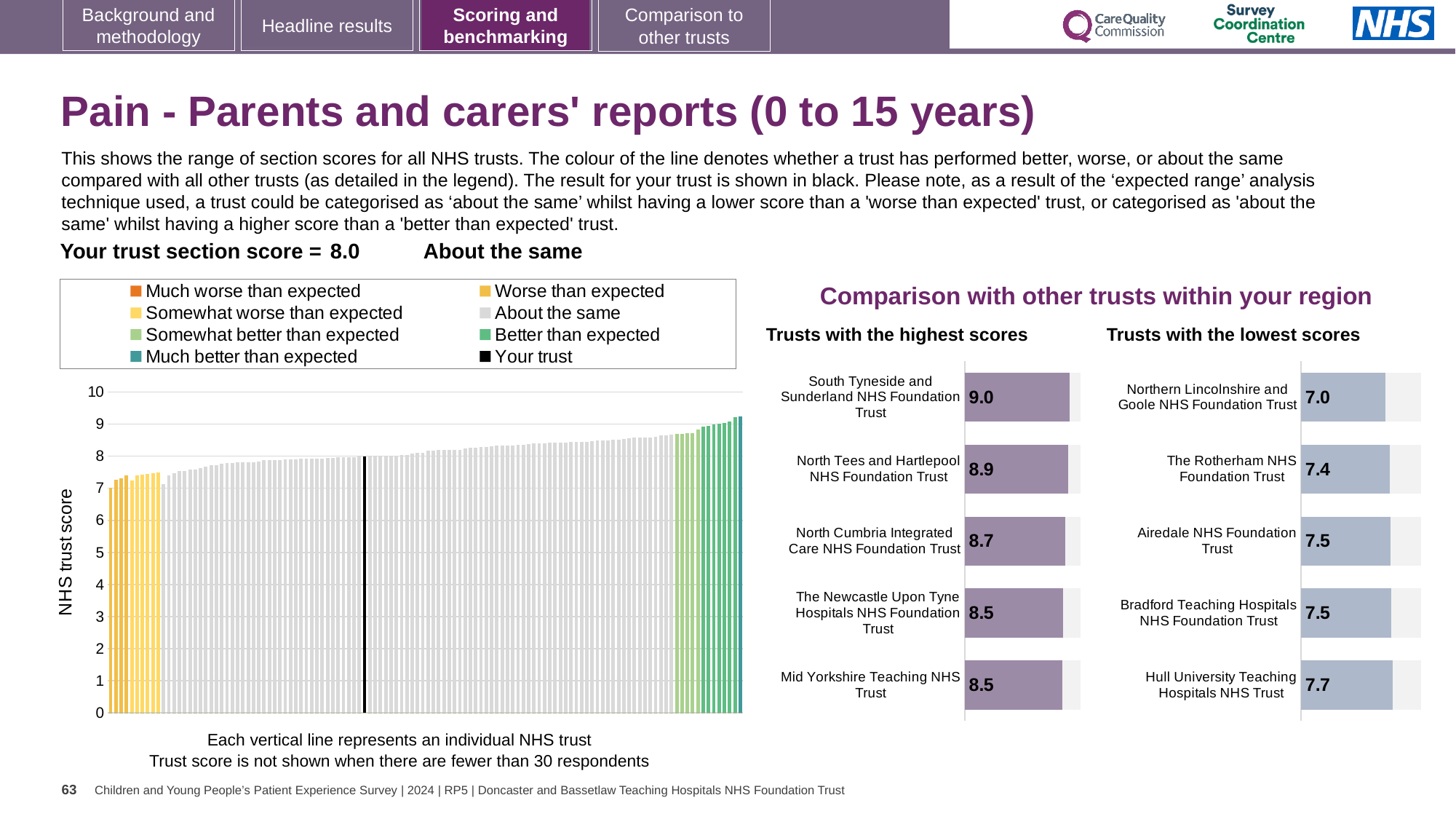
In the 'Trusts with the lowest scores' chart, how much higher is Hull University Teaching Hospitals NHS Trust's score than Northern Lincolnshire and Goole NHS Foundation Trust's score? 0.7 In the 'Trusts with the lowest scores' chart, what is the score for Hull University Teaching Hospitals NHS Trust? 7.7 In the 'Trusts with the lowest scores' chart, which trust has the lowest score? Northern Lincolnshire and Goole NHS Foundation Trust How many trusts are listed in the 'Trusts with the lowest scores' chart? 5 In the 'Trusts with the highest scores' chart, which trust has the highest score? South Tyneside and Sunderland NHS Foundation Trust In the 'Trusts with the highest scores' chart, what is the score for South Tyneside and Sunderland NHS Foundation Trust? 9.0 What kind of chart is the large 'NHS trust score' chart on the left of the slide? bar chart In the 'NHS trust score' chart on the left, do the bar values rise or fall from left to right? rise In the 'Trusts with the highest scores' chart, what is the difference between the scores of South Tyneside and Sunderland NHS Foundation Trust and Mid Yorkshire Teaching NHS Trust? 0.5 In the 'Trusts with the highest scores' chart, which has the higher score: North Tees and Hartlepool NHS Foundation Trust or North Cumbria Integrated Care NHS Foundation Trust? North Tees and Hartlepool NHS Foundation Trust In the 'NHS trust score' chart on the left, what is the section score for your trust (the black bar)? 8.0 In the 'NHS trust score' chart on the left, is the tallest bar greater or less than 9? greater